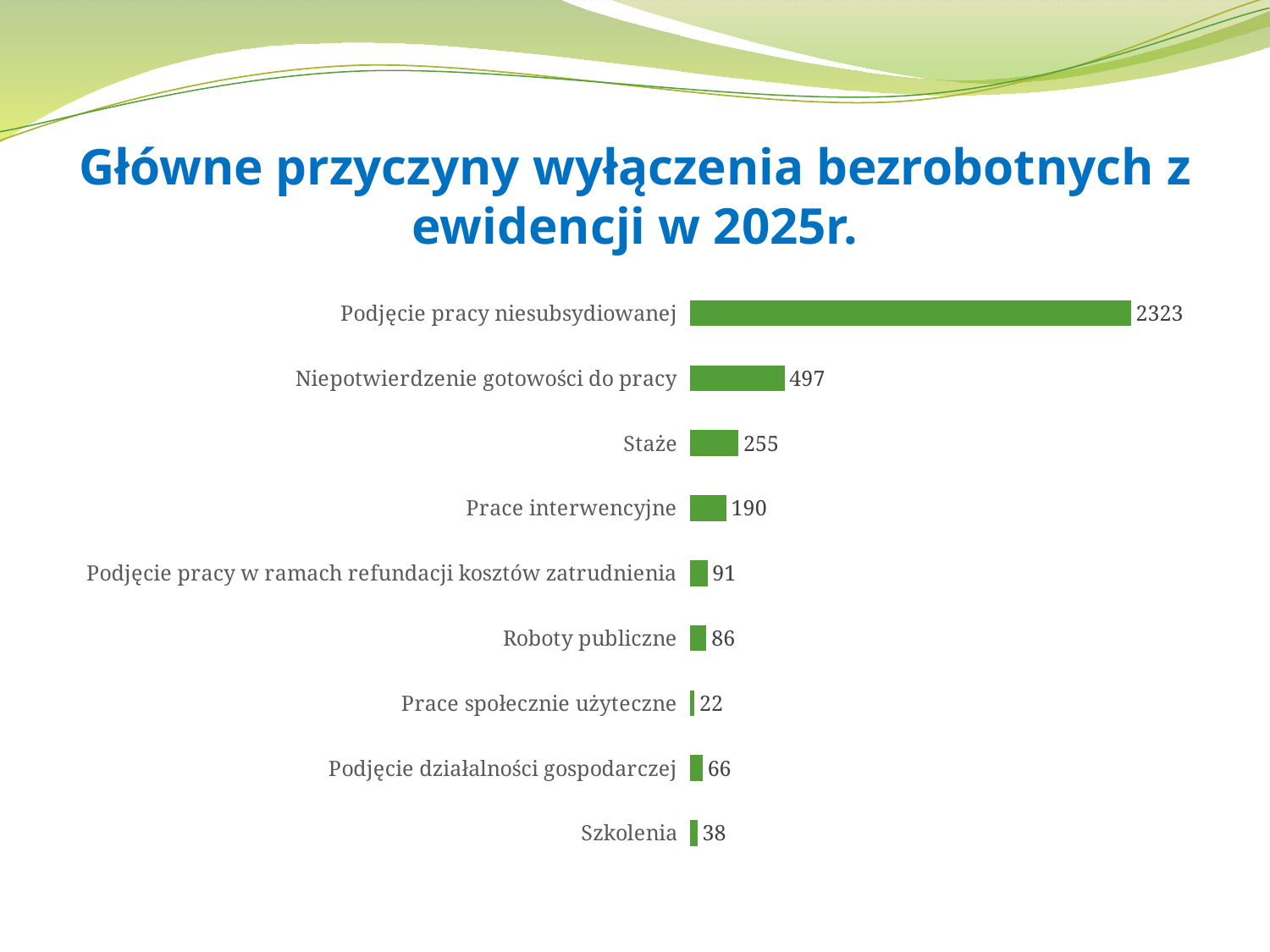
What is the value for Staże? 255 What is the difference between the values for Prace interwencyjne and Podjęcie pracy w ramach refundacji kosztów zatrudnienia? 99 What is the value for Niepotwierdzenie gotowości do pracy? 497 What kind of chart is shown on the slide? Bar chart Which category has the highest value? Podjęcie pracy niesubsydiowanej What is the value for Szkolenia? 38 What is the value for Podjęcie pracy niesubsydiowanej? 2323 How many categories are shown in the chart? 9 Which is larger, the value for Roboty publiczne or the value for Podjęcie działalności gospodarczej? Roboty publiczne Which category has the lowest value? Prace społecznie użyteczne What is the title of the slide? Główne przyczyny wyłączenia bezrobotnych z ewidencji w 2025r. What is the difference between the values for Niepotwierdzenie gotowości do pracy and Staże? 242